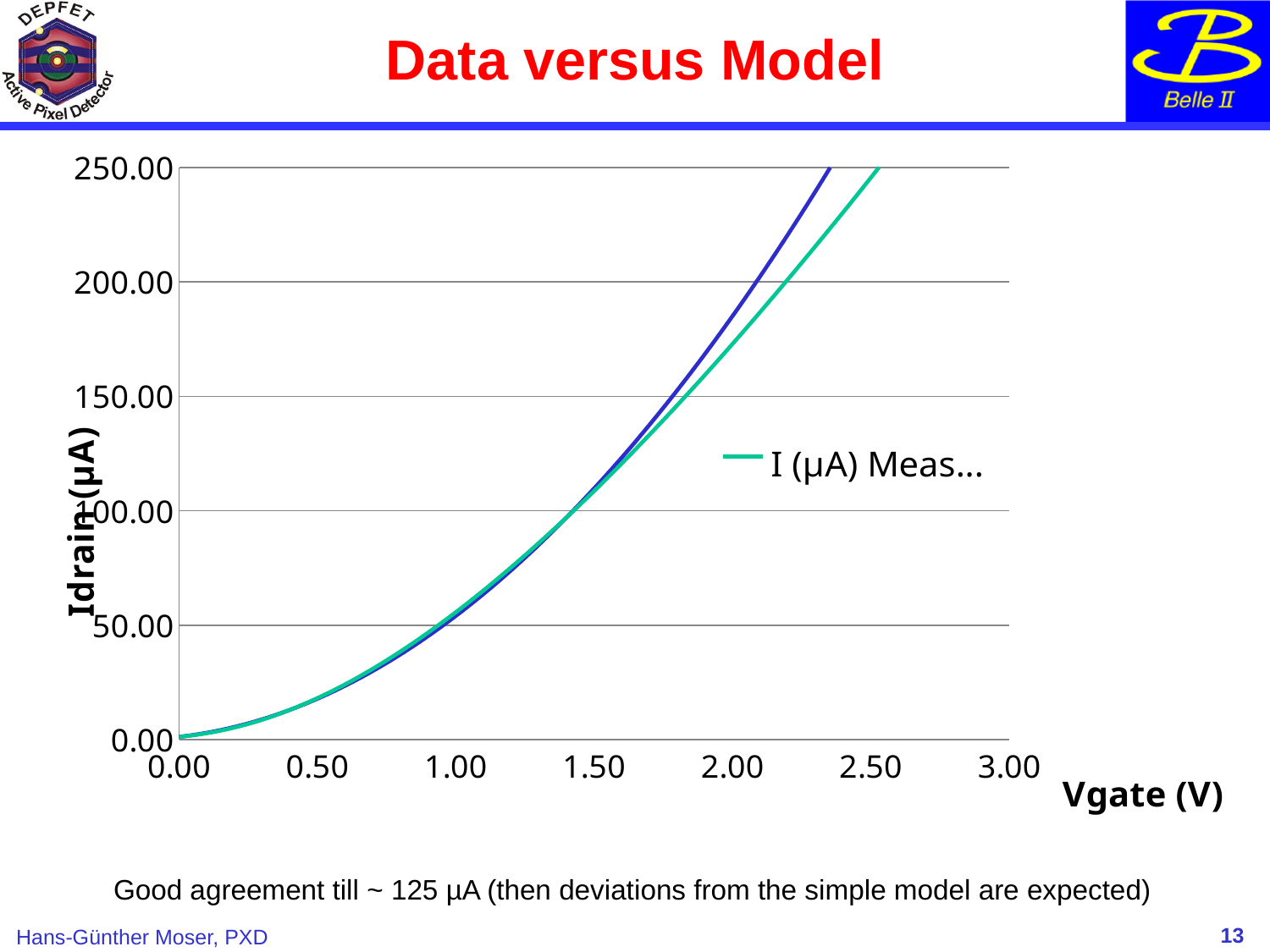
Do the plotted values rise or fall as Vgate increases? rise Is the value of the green line at Vgate 2.00 greater or less than 150? greater What kind of chart is shown on the slide? line chart What is the label of the y axis? Idrain (µA) Is the value of the blue line at Vgate 0.50 greater or less than 50? less At Vgate 2.00, which line has the larger value, the blue line or the green line? the blue line What is the label of the x axis? Vgate (V) How many lines are plotted on the chart? 2 Is the value of the green line at Vgate 2.00 greater or less than 200? less What is the highest value shown on the y axis? 250.00 How many entries does the legend list? 1